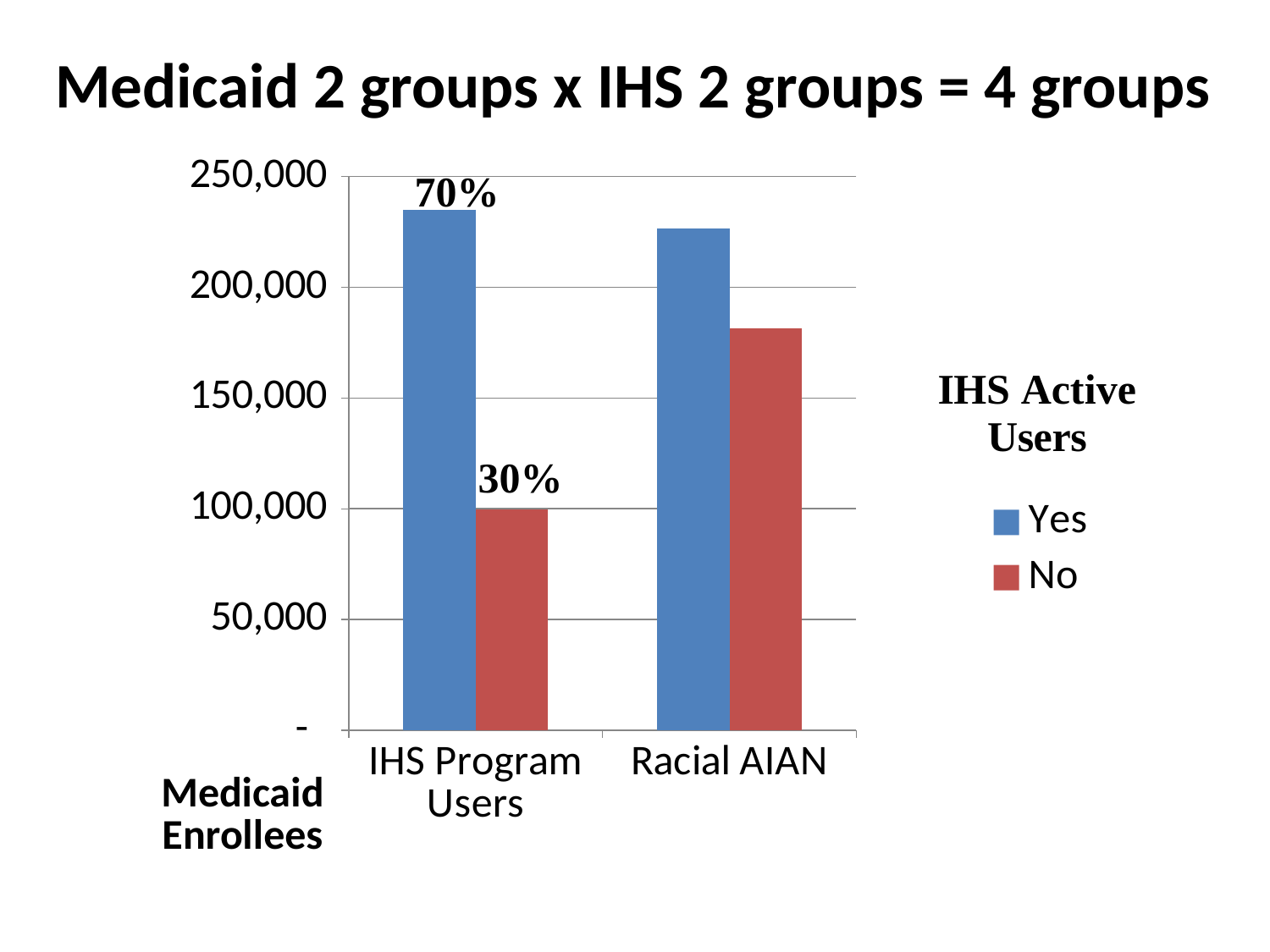
What percentage label is printed on the 'No' bar for IHS Program Users? 30% For Racial AIAN, which is larger: the 'Yes' bar or the 'No' bar? Yes How many series does the legend list? 2 How many categories are shown on the x axis of the chart? 2 Is the 'Yes' value for Racial AIAN greater or less than 200,000? greater Is the 'Yes' value for IHS Program Users greater or less than 200,000? greater What kind of chart is shown on the slide? bar chart What label is shown below the y axis of the chart? Medicaid Enrollees Is the 'No' value for Racial AIAN greater or less than 200,000? less Which bar is the lowest in the chart? No for IHS Program Users What is the title of the legend on the chart? IHS Active Users What percentage label is printed on the 'Yes' bar for IHS Program Users? 70%